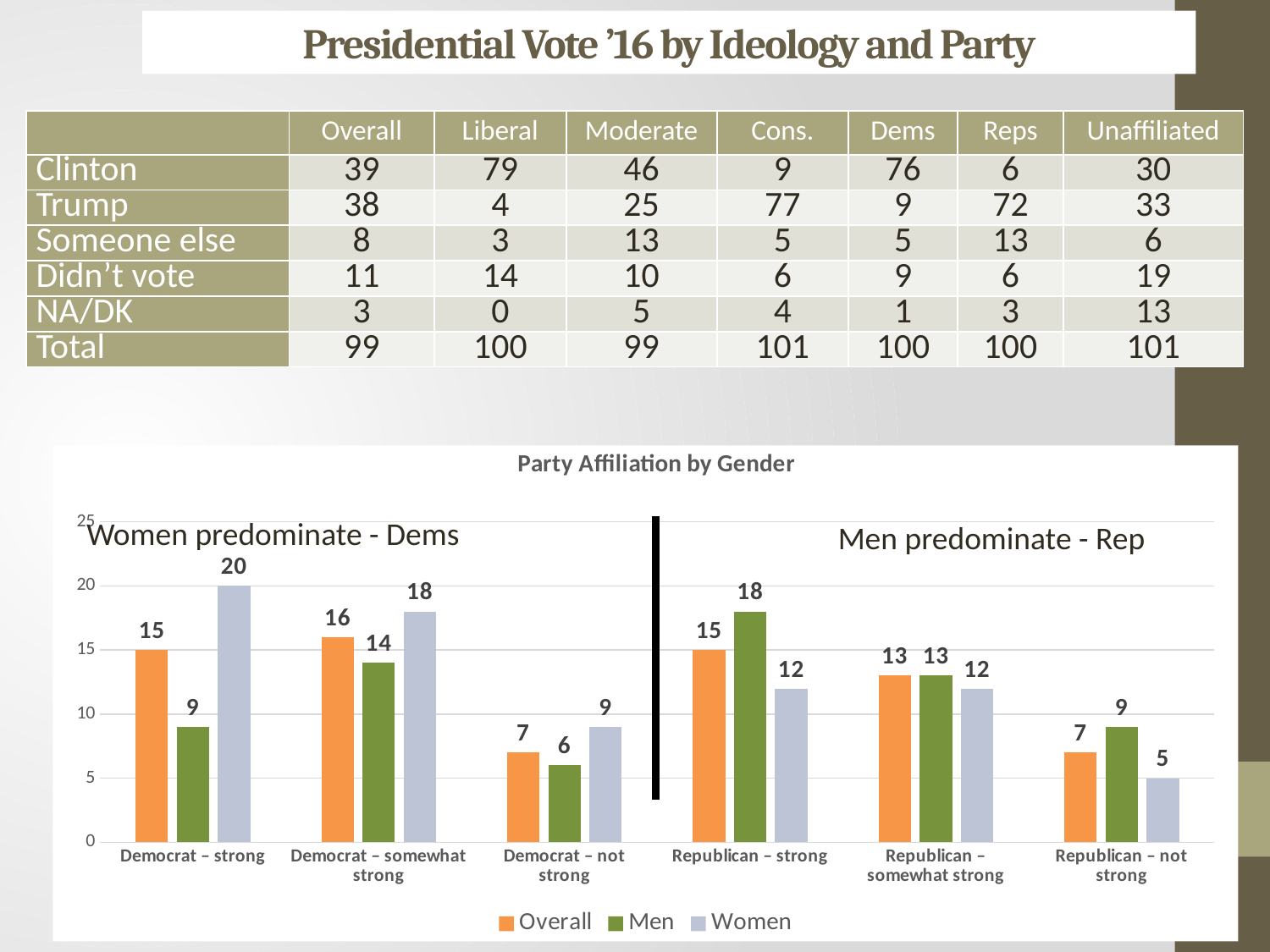
How many categories are shown on the x axis of the chart? 6 In the Republican – strong category, which is larger, the Men value or the Women value? Men Which series is shown in orange in the chart? Overall What is the value for Women in the Democrat – strong category? 20 What kind of chart is shown on the slide? bar chart Which category has the lowest value for Women? Republican – not strong What is the difference between the Women and Men values in the Democrat – strong category? 11 What is the value for Men in the Republican – strong category? 18 How many series does the chart legend list? 3 What is the title of the chart? Party Affiliation by Gender What is the Overall value for the Democrat – somewhat strong category? 16 Which category has the highest value for Women? Democrat – strong